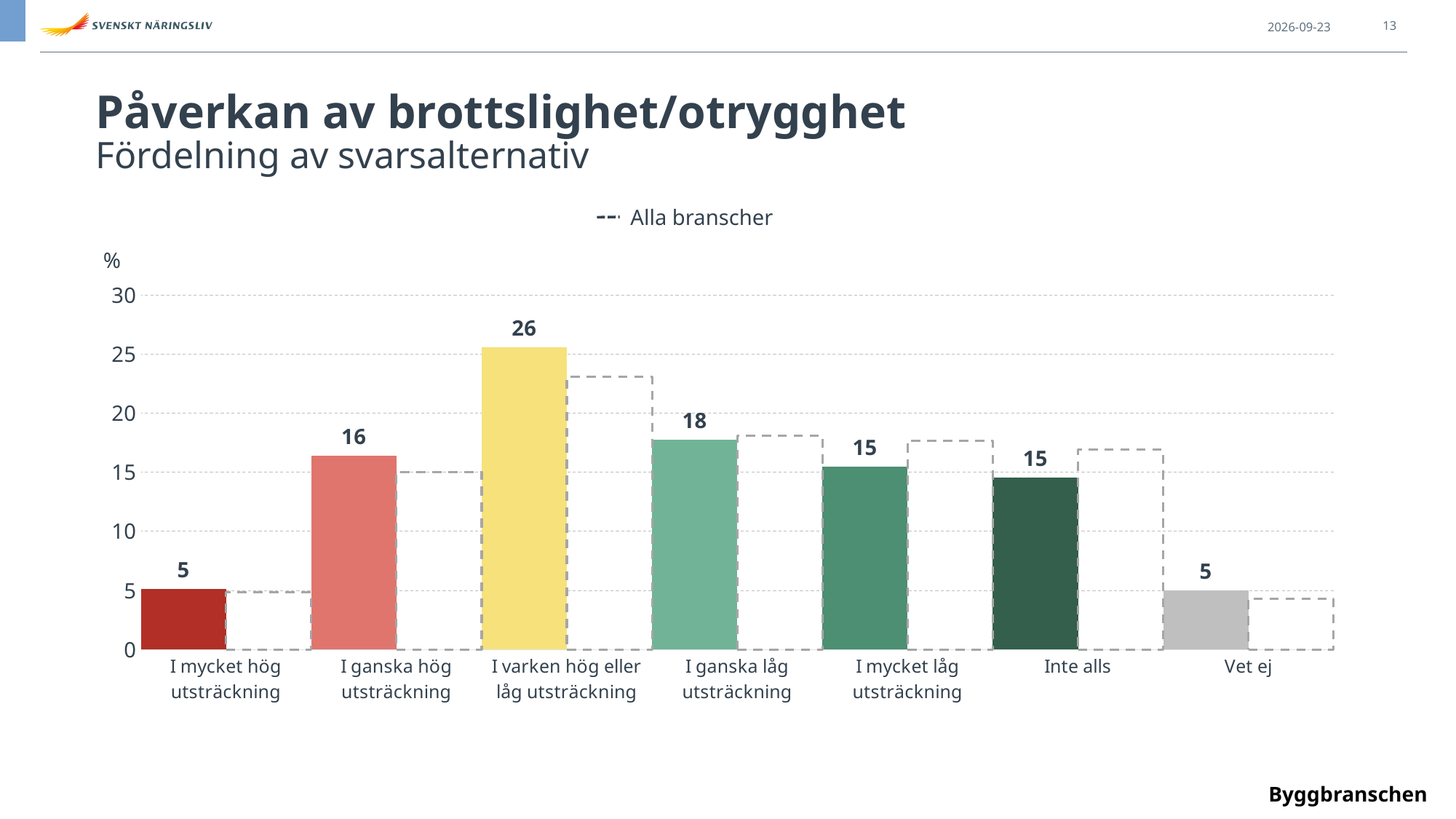
Which is larger, the value for "I ganska hög utsträckning" or "I ganska låg utsträckning"? I ganska låg utsträckning What is the value for "I varken hög eller låg utsträckning"? 26 Which category has the highest value? I varken hög eller låg utsträckning What entry does the legend list? Alla branscher Is the dashed "Alla branscher" value for "I varken hög eller låg utsträckning" greater or less than 20? greater What is the difference between the values for "I varken hög eller låg utsträckning" and "I ganska låg utsträckning"? 8 What is the value for "Vet ej"? 5 What is the value for "I ganska låg utsträckning"? 18 How many categories are shown on the x axis? 7 What is the value for "Inte alls"? 15 What unit is shown on the y axis? % What kind of chart is shown on the slide? bar chart